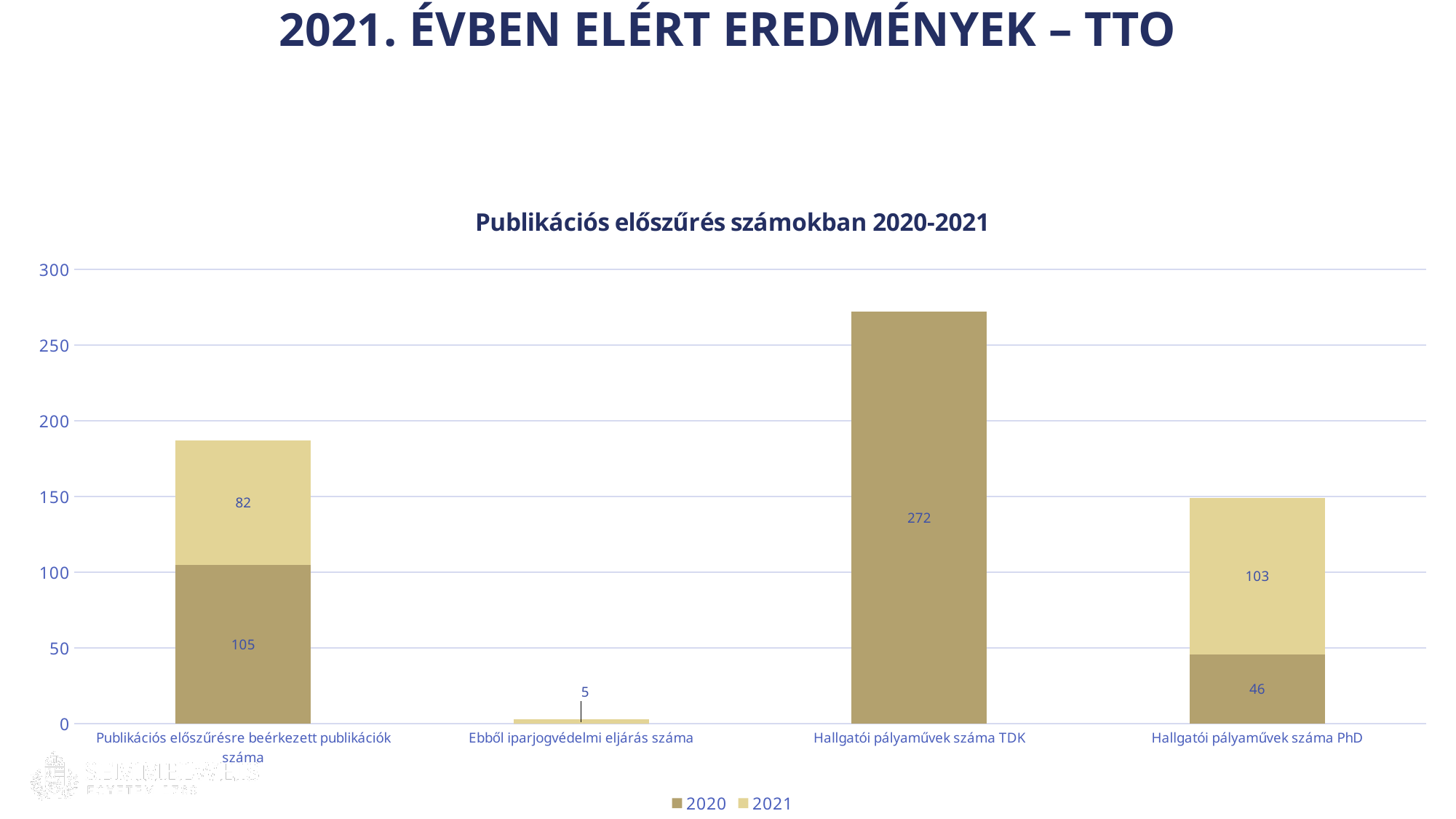
What is the 2021 value for "Hallgatói pályaművek száma PhD"? 103 What is the 2020 value for "Hallgatói pályaművek száma TDK"? 272 What type of chart is shown on the slide? Stacked bar chart What is the 2020 value for "Publikációs előszűrésre beérkezett publikációk száma"? 105 Which category has the lowest 2021 value among those with a 2021 label? Ebből iparjogvédelmi eljárás száma What is the 2021 value for "Ebből iparjogvédelmi eljárás száma"? 5 What is the total of the stacked bar for "Publikációs előszűrésre beérkezett publikációk száma"? 187 Which is larger for "Publikációs előszűrésre beérkezett publikációk száma": the 2020 value or the 2021 value? 2020 How many categories are shown on the x axis? 4 How many series does the legend list? 2 Which category has the highest 2020 value? Hallgatói pályaművek száma TDK What is the difference between the 2021 and 2020 values for "Hallgatói pályaművek száma PhD"? 57